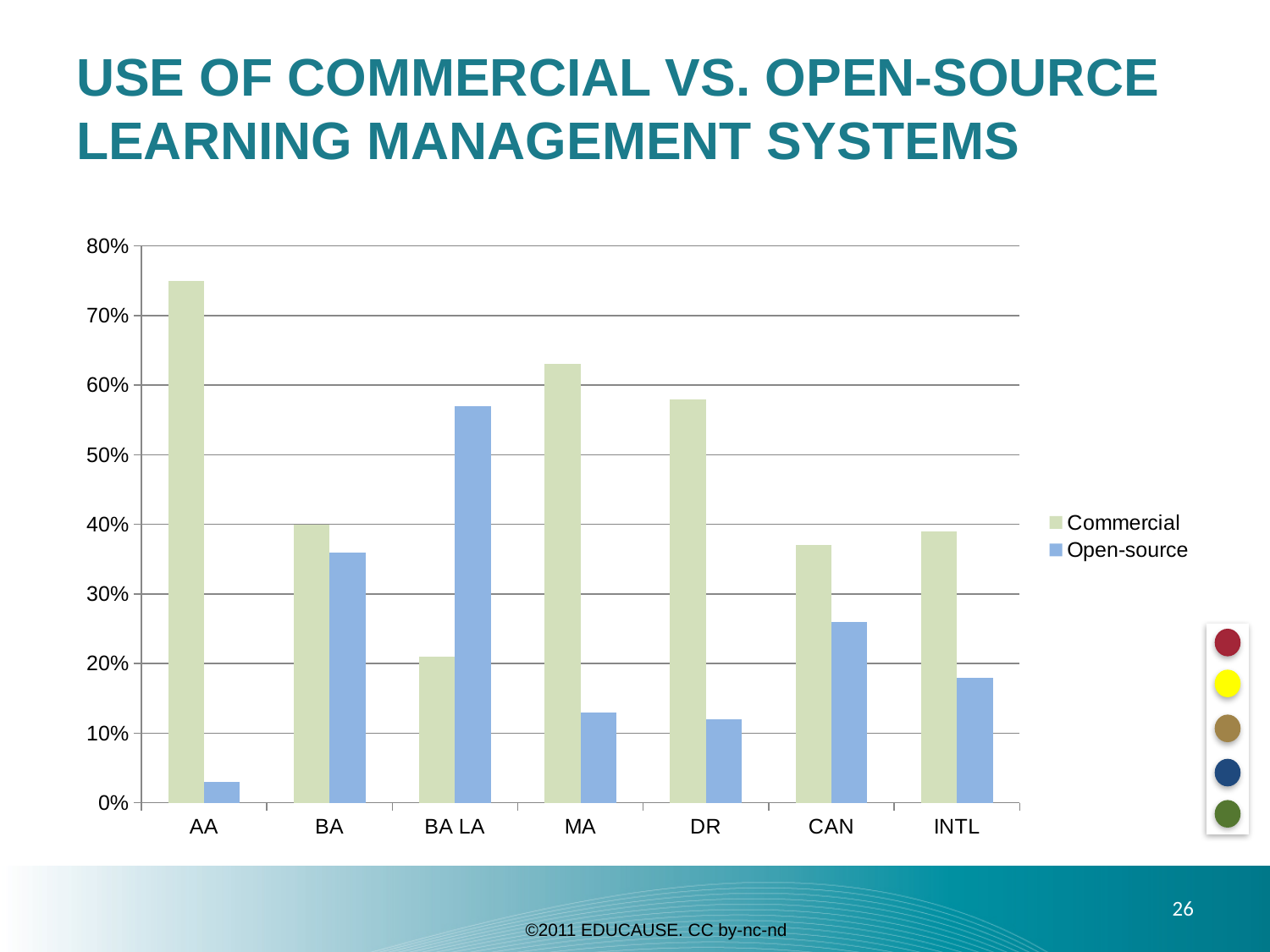
Is the Open-source value for MA greater or less than 20%? less Which category has the lowest Commercial value? BA LA For BA LA, which is larger: the Commercial value or the Open-source value? Open-source Which category has the lowest Open-source value? AA How many categories are shown on the x axis? 7 What kind of chart is shown on the slide? bar chart Which colour represents the Open-source series in the legend? blue Is the Commercial value for AA greater or less than 70%? greater Is the Open-source value for BA LA greater or less than 50%? greater Which category has the highest Commercial value? AA Which category has the highest Open-source value? BA LA How many series does the legend list? 2